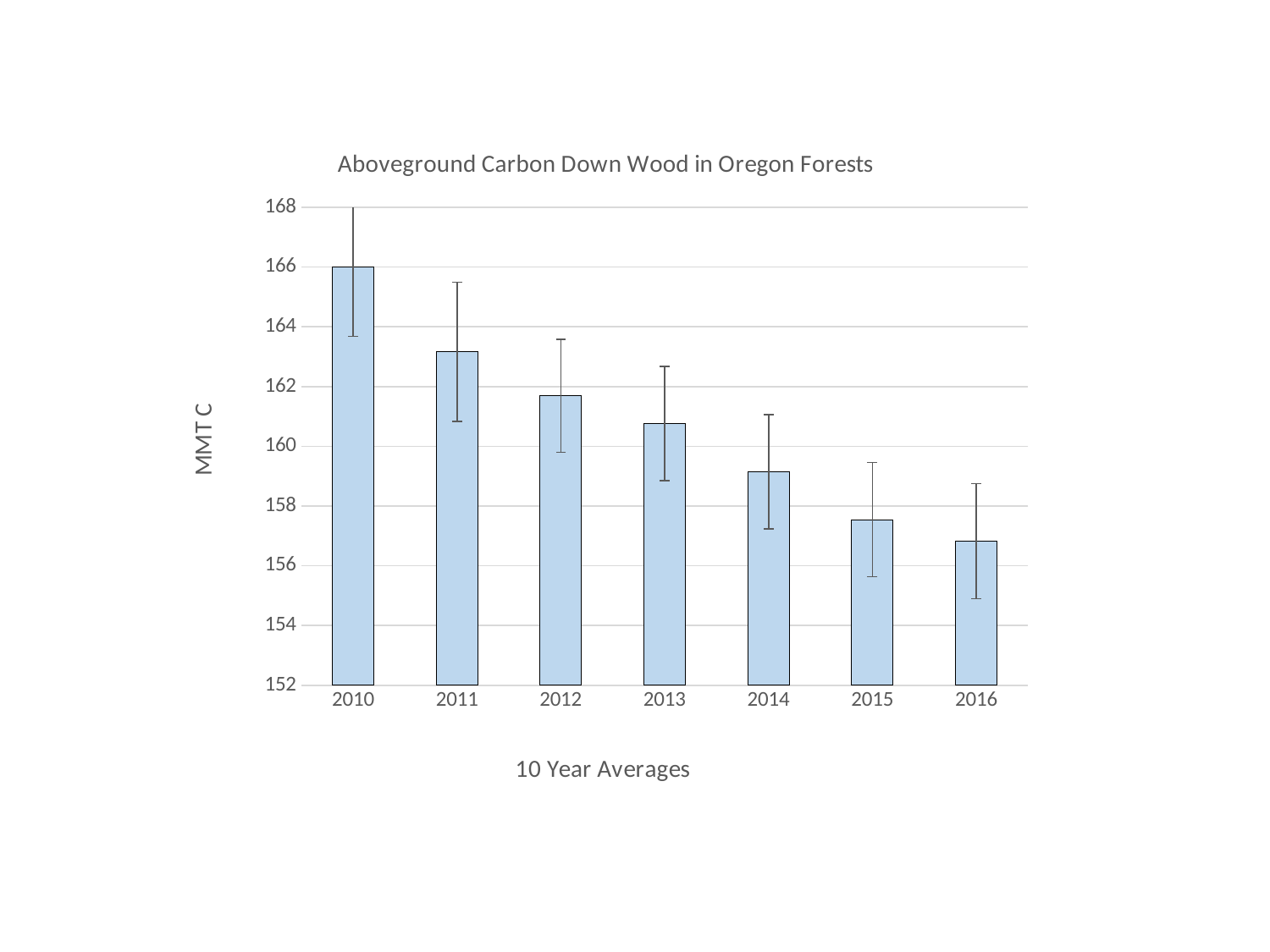
Is the value for 2011 greater or less than 162? greater Is the value for 2015 greater or less than 158? less How many years are plotted on the x axis? 7 Do the values rise or fall from 2010 to 2016? fall Is the value for 2012 greater or less than 160? greater Which year has the lowest aboveground carbon down wood value? 2016 What is the value for 2010 in MMT C? 166 Which year has the highest aboveground carbon down wood value? 2010 What is the label on the y axis? MMT C Which is larger, the value for 2011 or the value for 2013? 2011 What kind of chart is shown on the slide? bar chart